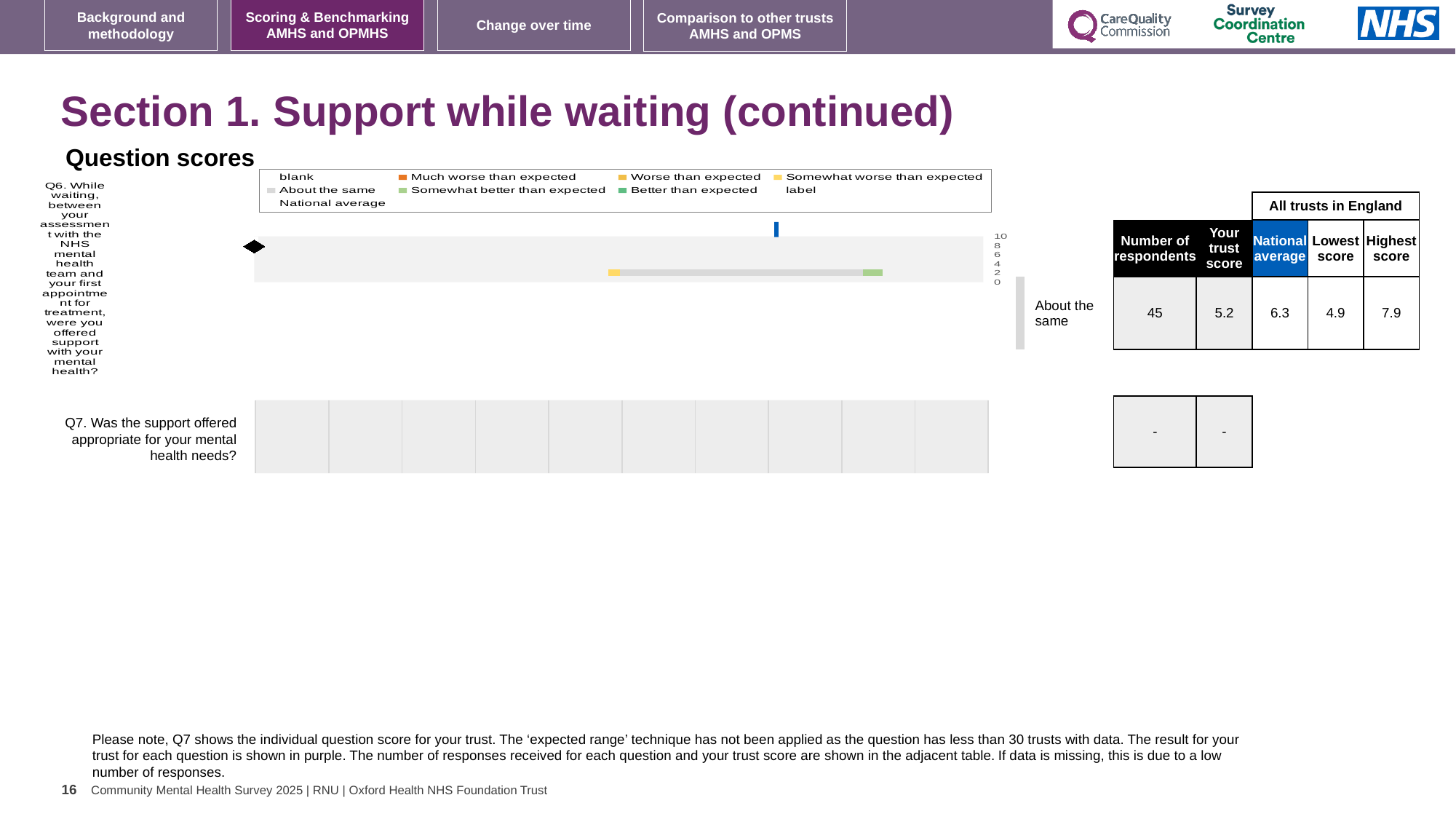
For Q6, which is larger: the trust score or the national average? National average How many respondents answered Q6? 45 What is the highest score across all trusts in England for Q6? 7.9 Is the trust score for Q6 greater or less than 6? less What expected-range category is the trust's Q6 result labelled as? About the same What is the trust score shown for Q6 (support while waiting between assessment and first appointment)? 5.2 What kind of chart is used to show the Q6 question score? Bar chart What is the difference between the highest score (7.9) and the lowest score (4.9) for Q6? 3.0 What is the highest value shown on the score axis of the Q6 chart? 10 What is the national average score shown for Q6? 6.3 What is the lowest score across all trusts in England for Q6? 4.9 What is the difference between the national average (6.3) and the trust score (5.2) for Q6? 1.1